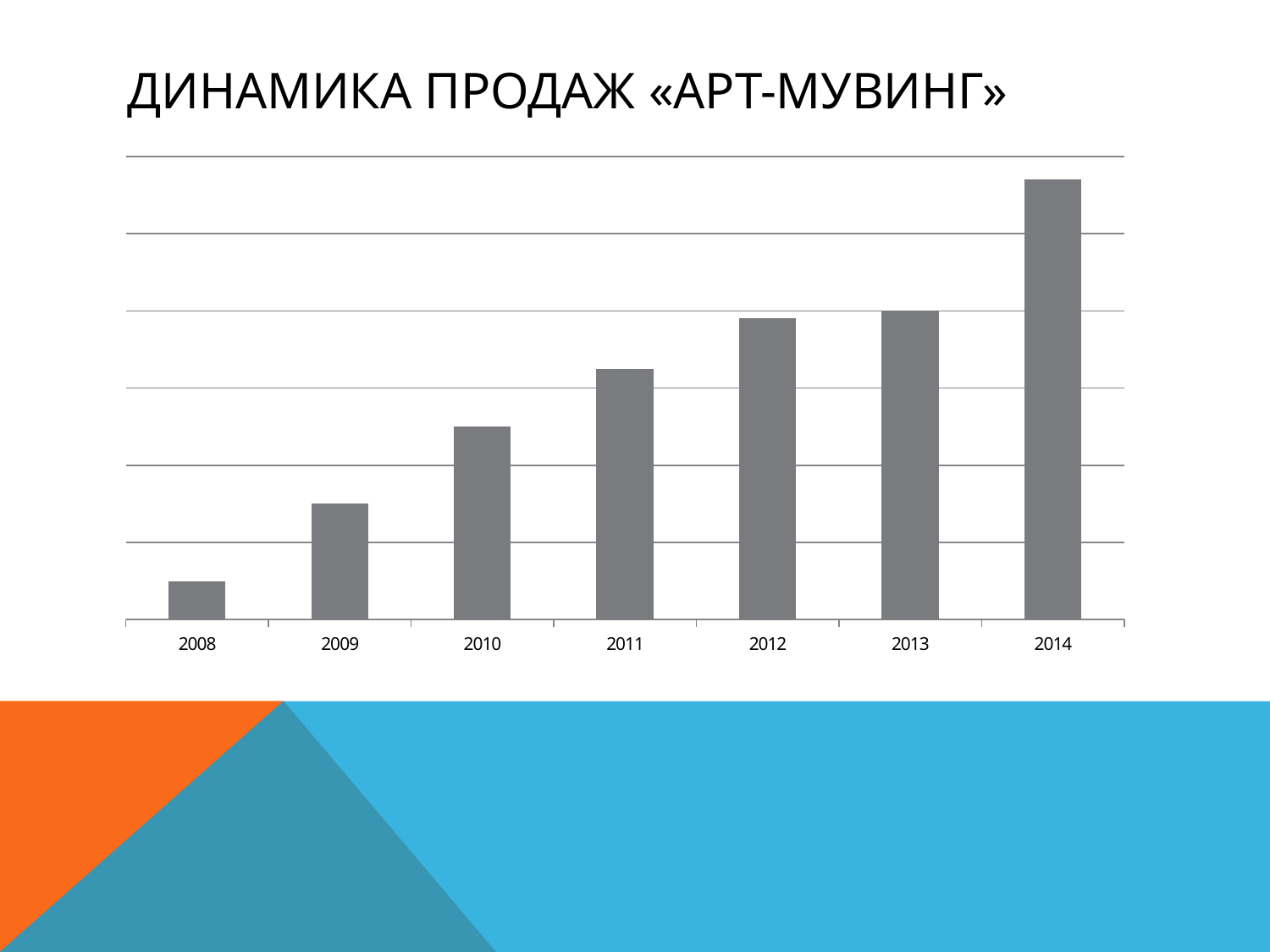
Which year has the larger value, 2008 or 2012? 2012 Do the values rise or fall from 2008 to 2014? rise How many years are shown on the x axis of the chart? 7 Which year has the larger value, 2010 or 2014? 2014 Which year has the larger value, 2009 or 2011? 2011 What is the first year shown on the x axis? 2008 What kind of chart is shown on the slide? bar chart What is the title of the slide containing the chart? ДИНАМИКА ПРОДАЖ «АРТ-МУВИНГ» Which year has the highest bar in the chart? 2014 Which year has the lowest bar in the chart? 2008 What colour are the bars in the chart? grey